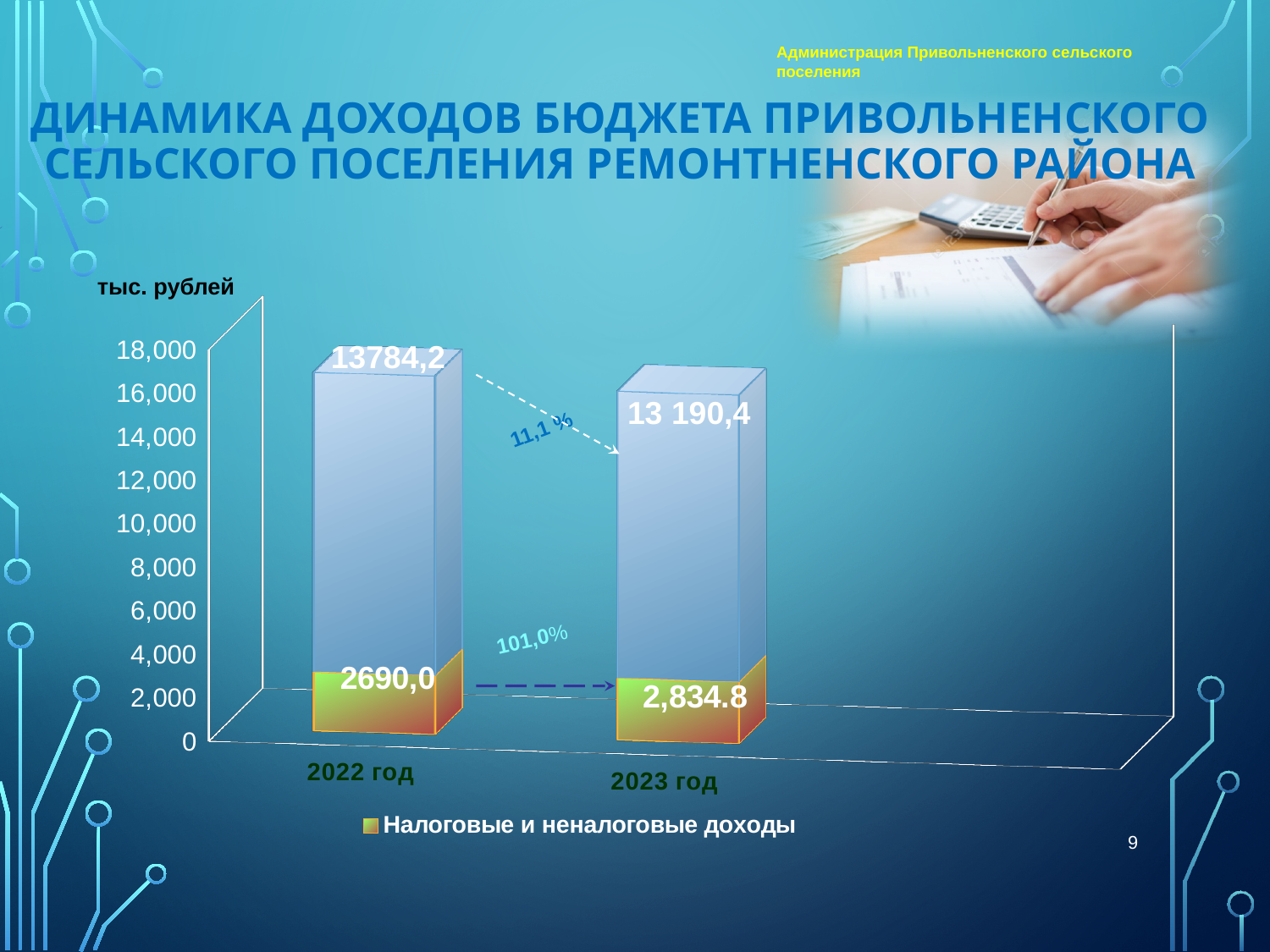
What is the value of Налоговые и неналоговые доходы for 2023 год? 2,834.8 Do the values labelled at the top of the bars rise or fall from 2022 год to 2023 год? Fall What value is labelled on the top of the 2022 год bar? 13784,2 What is the difference between the top-of-bar values for 2022 год (13784,2) and 2023 год (13 190,4)? 593,8 What is the only entry listed in the chart legend? Налоговые и неналоговые доходы What value is labelled on the top of the 2023 год bar? 13 190,4 What unit is indicated above the vertical axis of the chart? тыс. рублей What is the value of Налоговые и неналоговые доходы for 2022 год? 2690,0 How many years (categories) are shown on the x axis of the chart? 2 What kind of chart is shown on the slide? Bar chart Which year has the larger value labelled at the top of its bar, 2022 год or 2023 год? 2022 год Which year has the larger value for Налоговые и неналоговые доходы, 2022 год or 2023 год? 2023 год